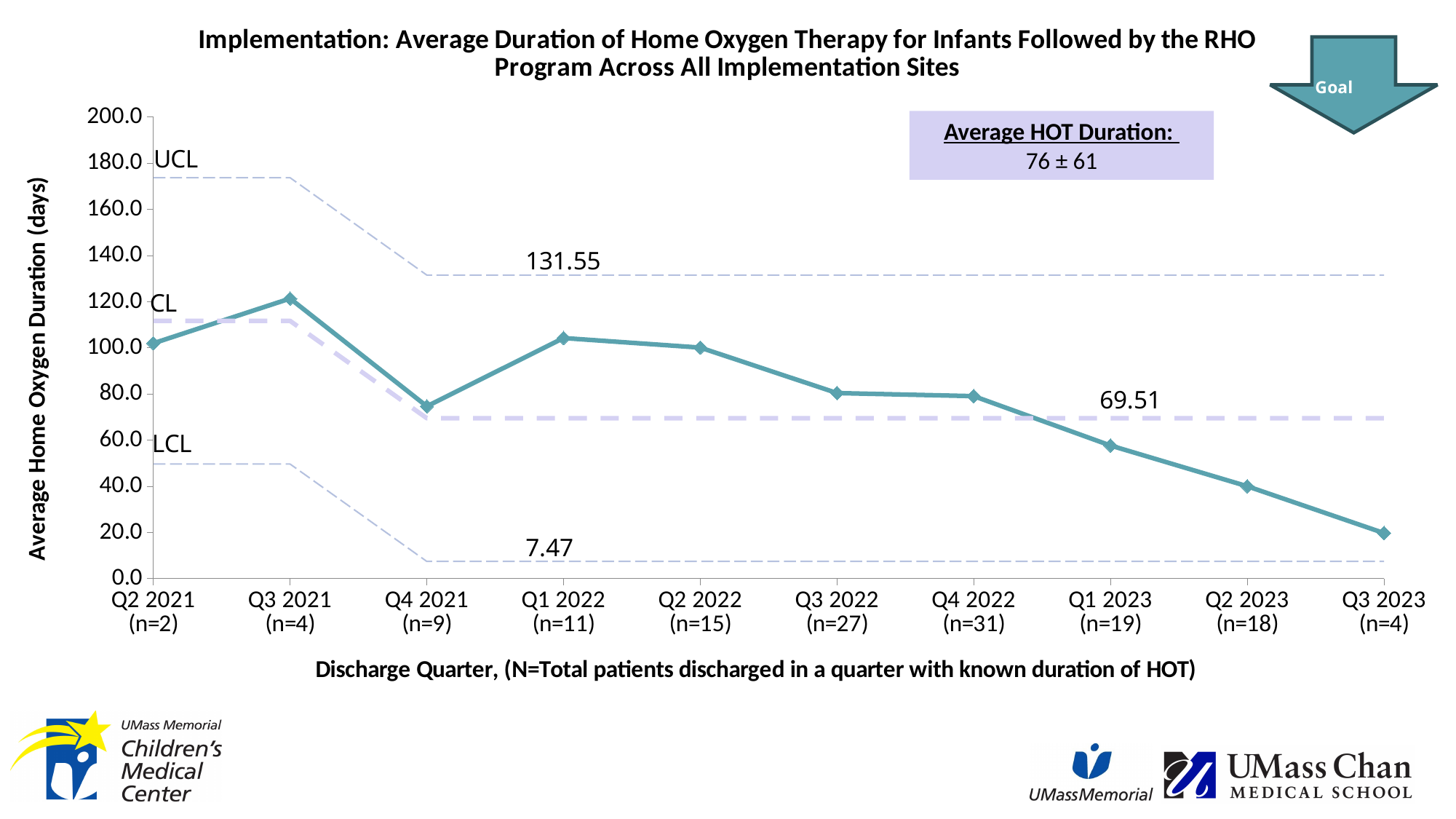
What is the value printed for the upper control limit (UCL) from Q4 2021 onward? 131.55 Is the average home oxygen duration for Q3 2023 greater or less than 40? less What is the average HOT duration stated in the box on the slide? 76 ± 61 From Q1 2022 to Q3 2023, does the average home oxygen duration rise or fall? fall What is the value printed for the center line (CL) from Q4 2021 onward? 69.51 How many discharge quarters are plotted along the x axis? 10 Which has the larger average home oxygen duration, Q1 2022 or Q3 2022? Q1 2022 Which discharge quarter has the lowest average home oxygen duration? Q3 2023 What is the value printed for the lower control limit (LCL) from Q4 2021 onward? 7.47 Which discharge quarter has the highest average home oxygen duration? Q3 2021 Is the average home oxygen duration for Q3 2021 greater or less than 100? greater What kind of chart is shown on the slide? line chart